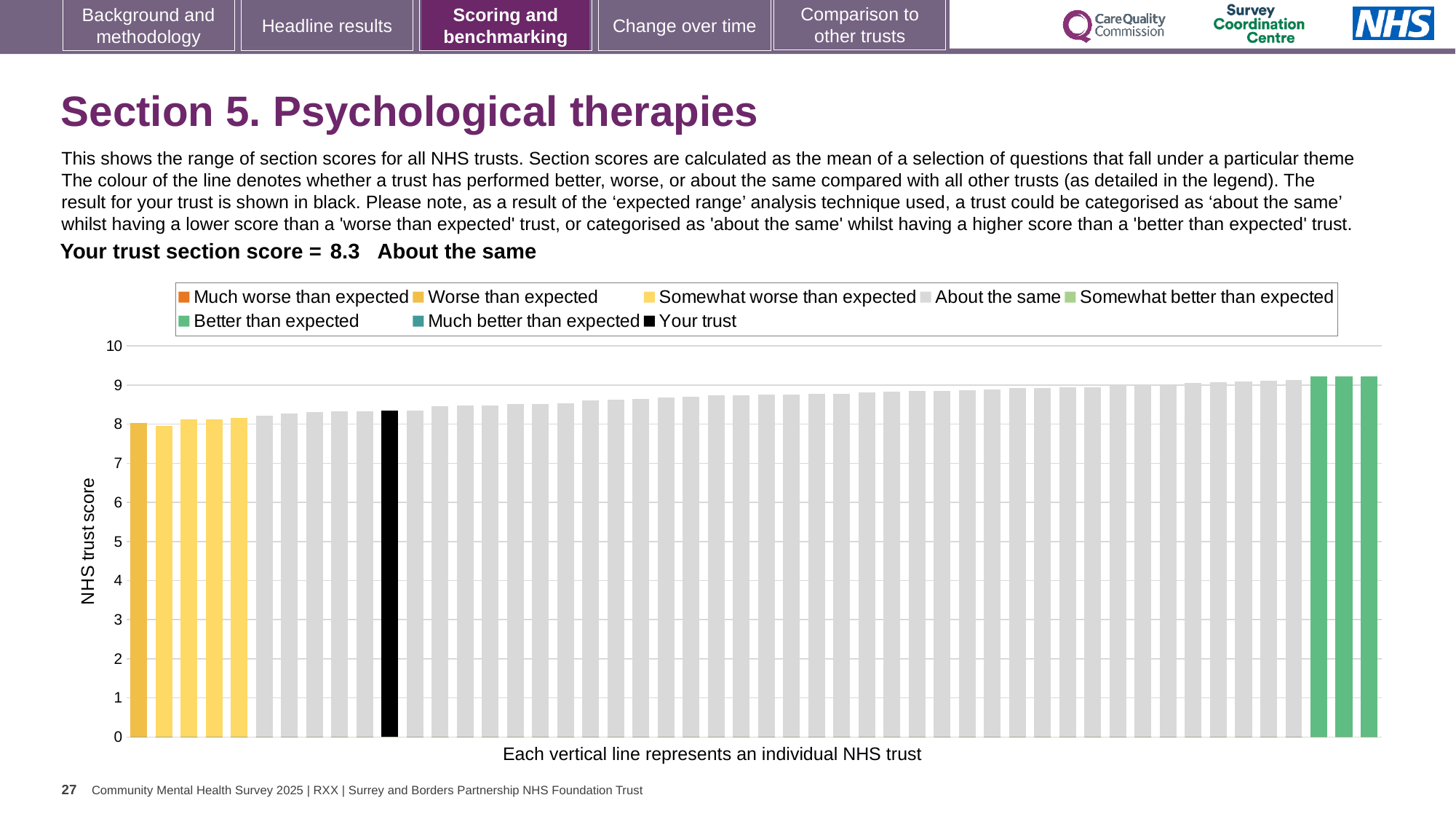
Is the value for the highest-scoring trust greater or less than 9? greater How many bars are coloured as 'Somewhat worse than expected' (light yellow)? 4 What is the section score for your trust shown on the slide? 8.3 Is the value for your trust greater or less than 8? greater How many entries does the chart legend list? 8 Which legend category contains the highest-scoring trusts on the chart? Better than expected Do the trust scores rise or fall from left to right along the x axis? rise What colour is the bar representing your trust? black How is your trust's section score categorised compared with other trusts? About the same What kind of chart is shown on the slide? bar chart What is the label on the vertical axis of the chart? NHS trust score How many bars are coloured as 'Better than expected' (green)? 3